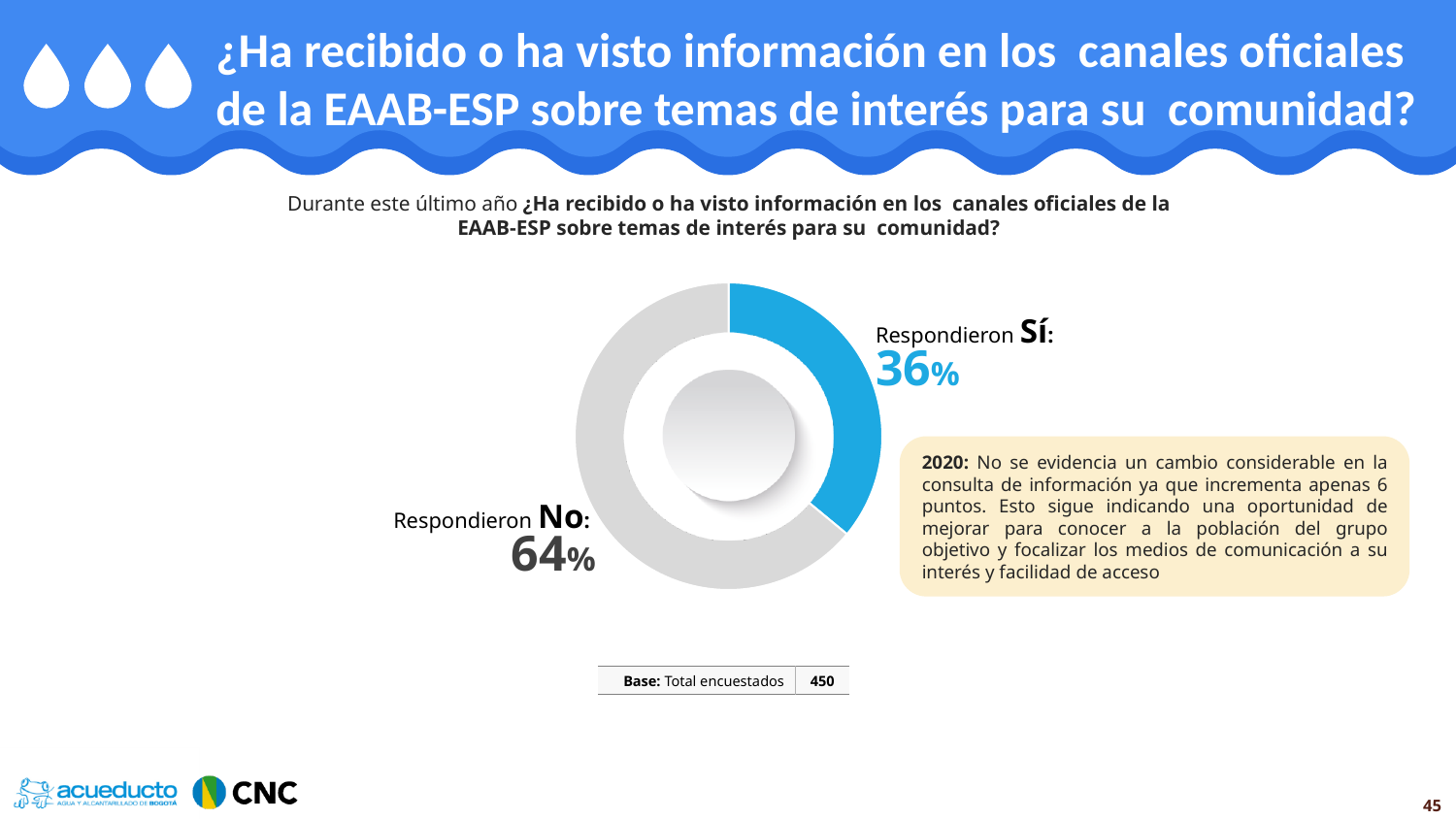
What colour is the "Sí" segment of the chart? Blue What percentage of respondents answered "Sí"? 36% What kind of chart is shown on the slide? Pie chart (donut) What is the total of the two percentages shown in the chart? 100% What is the base (total number of respondents) shown below the chart? 450 What percentage of respondents answered "No"? 64% How many categories does the chart show? 2 Which response has the larger share, "Sí" or "No"? No Which response has the smallest share of the chart? Sí What is the difference in percentage points between the "No" and "Sí" responses? 28